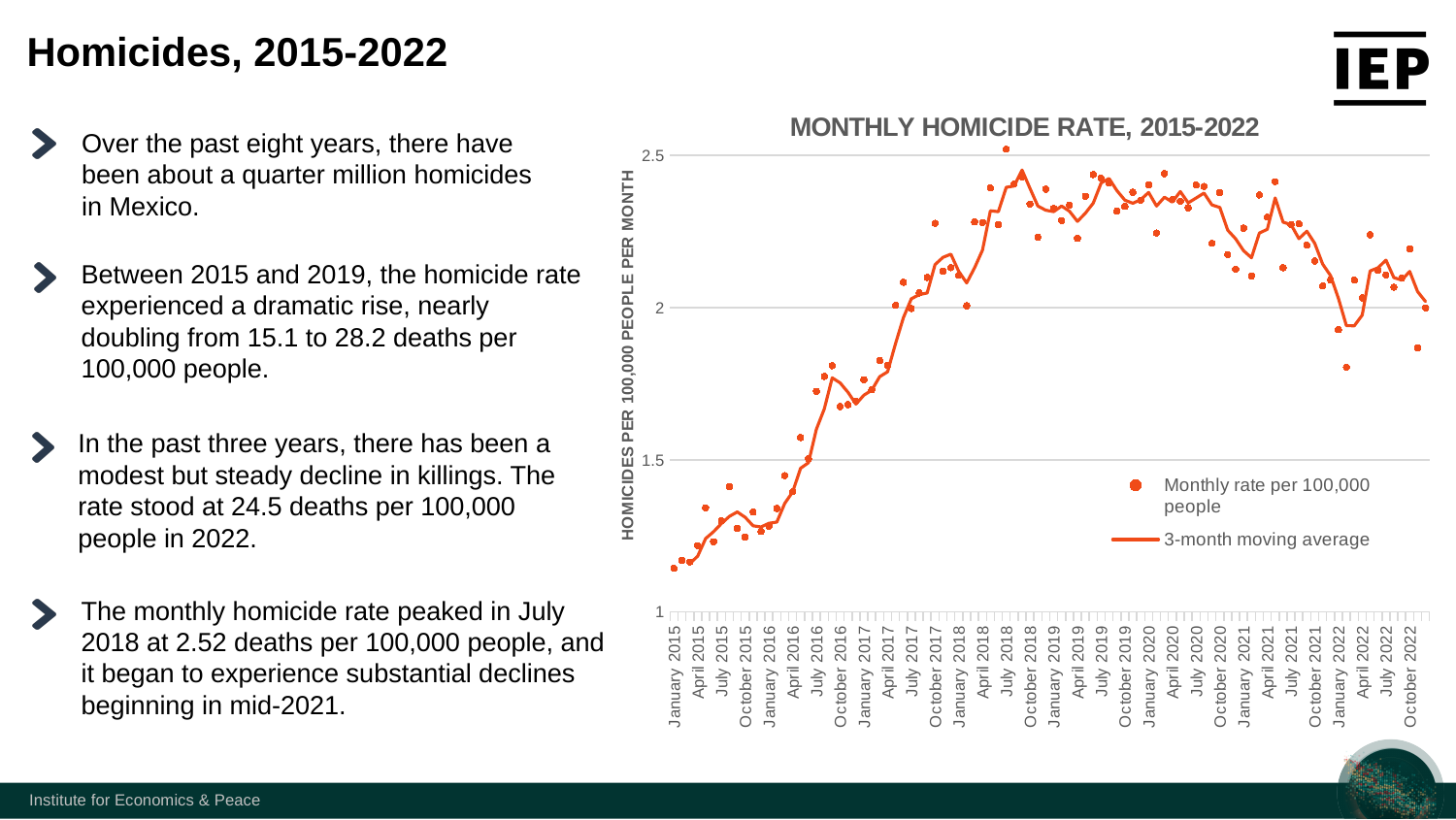
What is the title of the chart? MONTHLY HOMICIDE RATE, 2015-2022 Does the 3-month moving average rise or fall between July 2021 and October 2022? fall Is the monthly rate for January 2022 greater or less than 2? less Does the 3-month moving average rise or fall between January 2015 and July 2018? rise In which month does the monthly homicide rate reach its highest point on the chart? July 2018 What are the two series named in the chart legend? Monthly rate per 100,000 people; 3-month moving average Which has the higher monthly homicide rate, January 2015 or July 2018? July 2018 How many series does the chart legend list? 2 Is the monthly rate for January 2015 greater or less than 1.5? less Is the monthly rate for January 2017 greater or less than 2? less